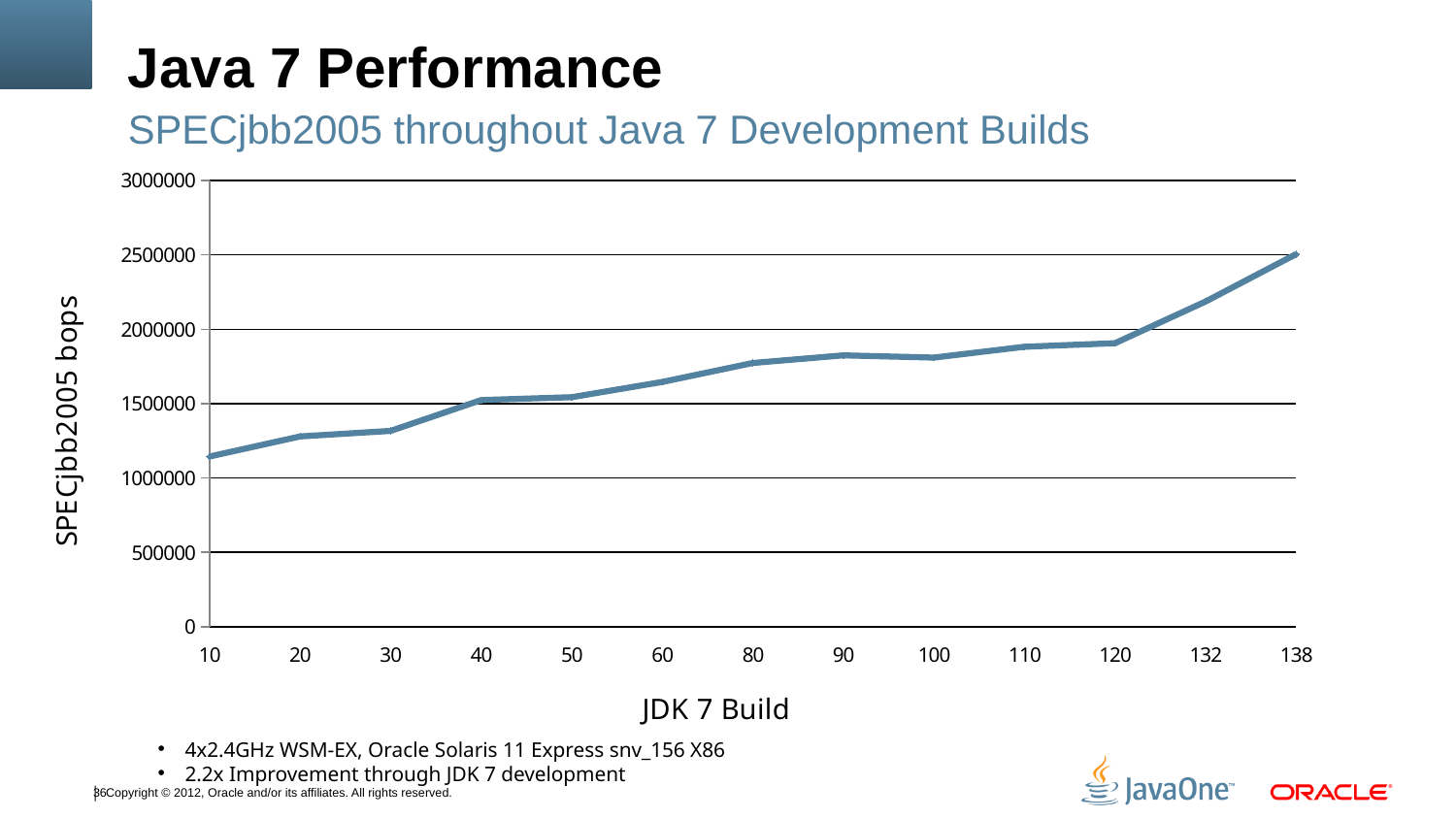
Which JDK 7 build has the lowest SPECjbb2005 bops value? 10 What kind of chart is shown on the slide? line chart What is the label on the x axis of the chart? JDK 7 Build Is the value for build 40 greater or less than 1000000? greater Is the value for build 132 greater or less than 2000000? greater How many JDK 7 builds are plotted along the x axis? 13 Is the value for build 120 greater or less than 2000000? less Which JDK 7 build has the highest SPECjbb2005 bops value? 138 Do the SPECjbb2005 bops values generally rise or fall as the JDK 7 build number increases? rise Which has the larger SPECjbb2005 bops value, build 60 or build 100? build 100 What is the label on the y axis of the chart? SPECjbb2005 bops